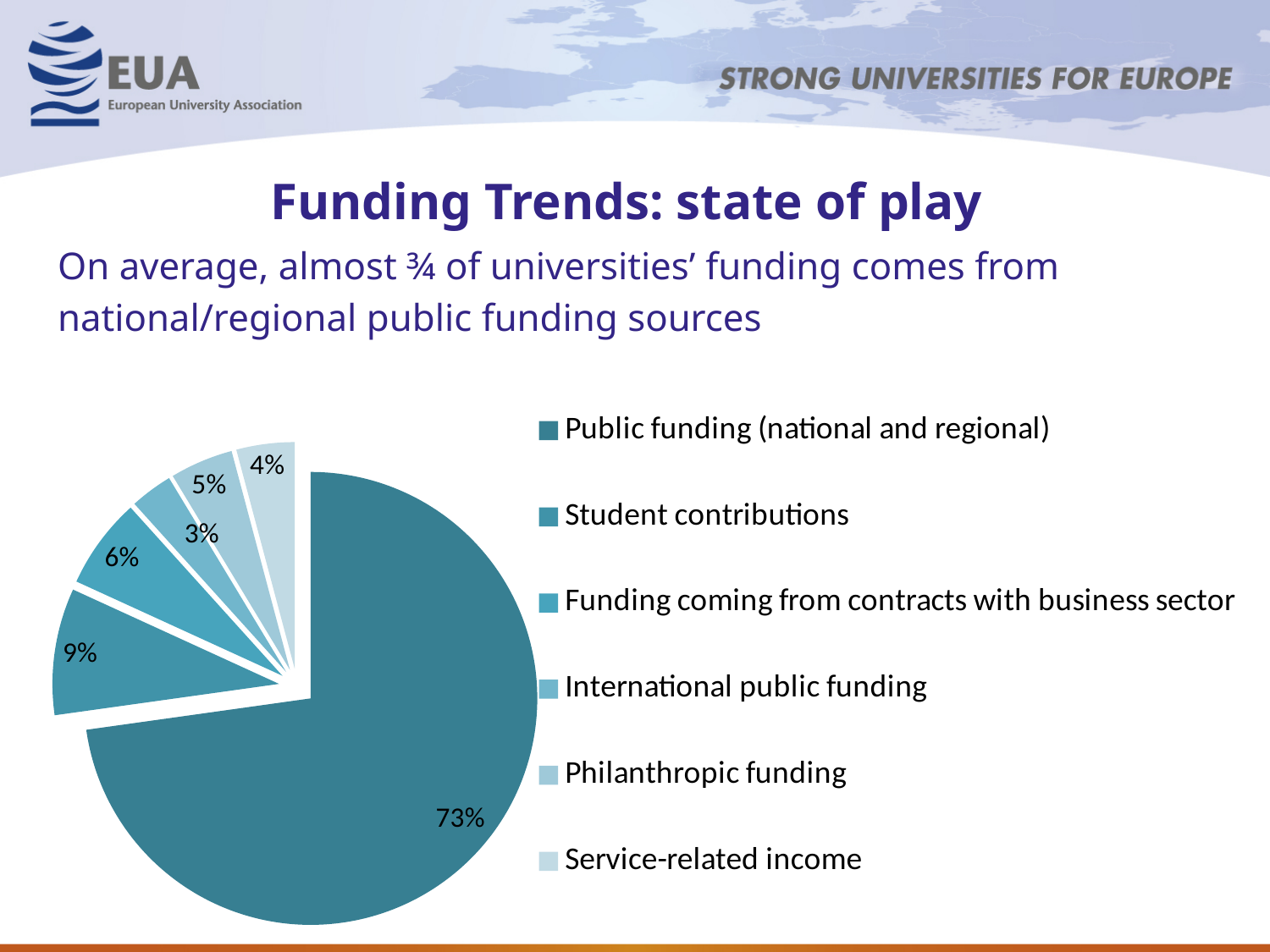
What is the value for Student contributions? 9% What is the value for International public funding? 3% What is the value for Funding coming from contracts with business sector? 6% Which category has the smallest slice of the pie? International public funding Which category has the largest slice of the pie? Public funding (national and regional) What is the value for Service-related income? 4% What kind of chart is shown on the slide? pie chart What share of the pie is Public funding (national and regional)? 73% How many categories does the legend list? 6 Which is larger, Philanthropic funding or Service-related income? Philanthropic funding What is the difference between the Student contributions slice and the Philanthropic funding slice? 4% What is the value for Philanthropic funding? 5%